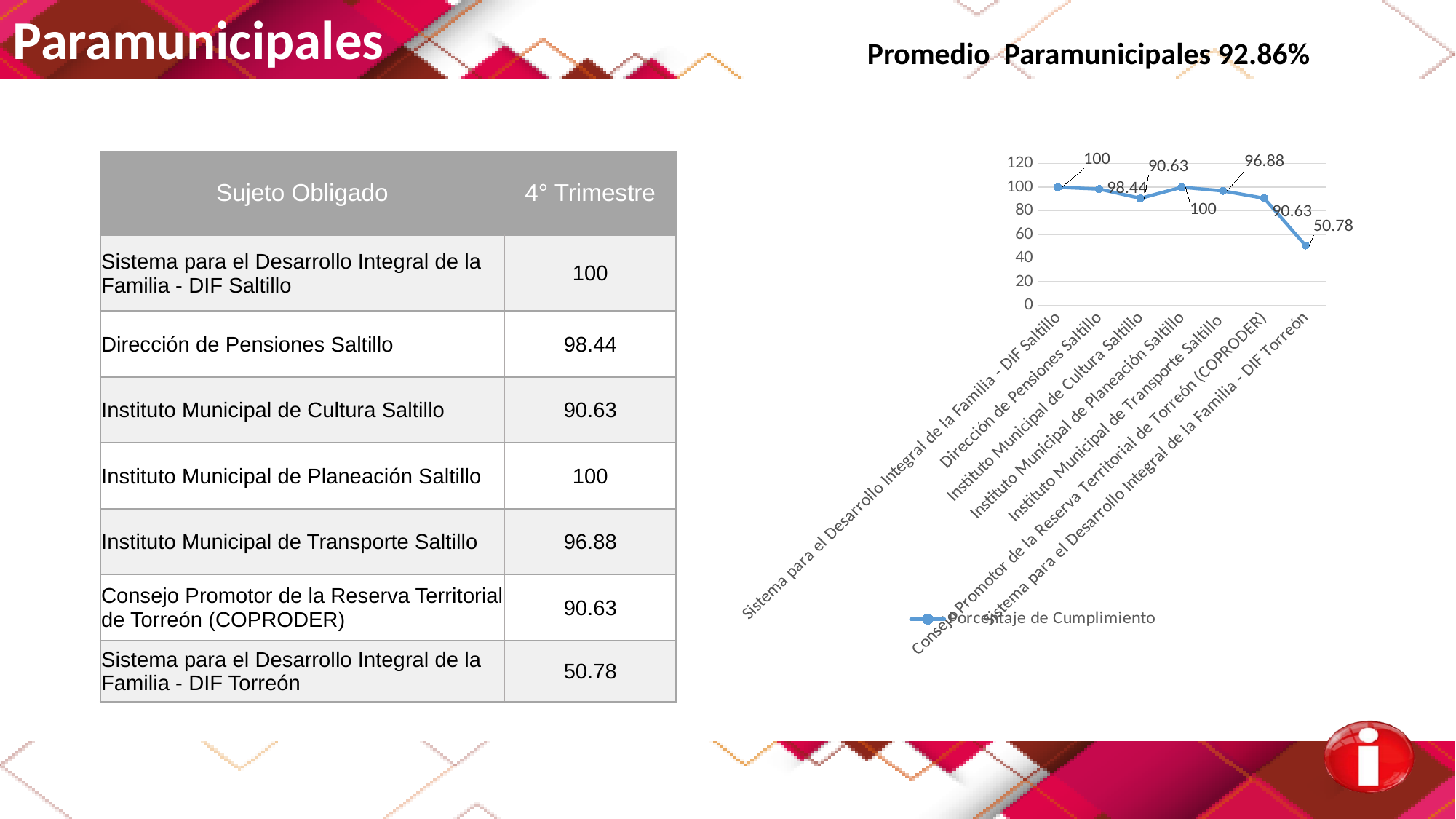
What is the name of the series shown in the chart legend? Porcentaje de Cumplimiento Which category has the lowest value in the chart? Sistema para el Desarrollo Integral de la Familia - DIF Torreón How many categories are plotted on the x axis of the chart? 7 What is the value for Instituto Municipal de Cultura Saltillo in the chart? 90.63 What is the difference between the values for Instituto Municipal de Planeación Saltillo and Sistema para el Desarrollo Integral de la Familia - DIF Torreón? 49.22 Which is larger, the value for Dirección de Pensiones Saltillo or the value for Instituto Municipal de Transporte Saltillo? Dirección de Pensiones Saltillo Is the value for Sistema para el Desarrollo Integral de la Familia - DIF Torreón greater or less than 60? less How many series does the chart legend list? 1 What is the value for Sistema para el Desarrollo Integral de la Familia - DIF Torreón in the chart? 50.78 What kind of chart is shown on the slide? line chart What is the value for Instituto Municipal de Transporte Saltillo in the chart? 96.88 What is the value for Dirección de Pensiones Saltillo in the chart? 98.44